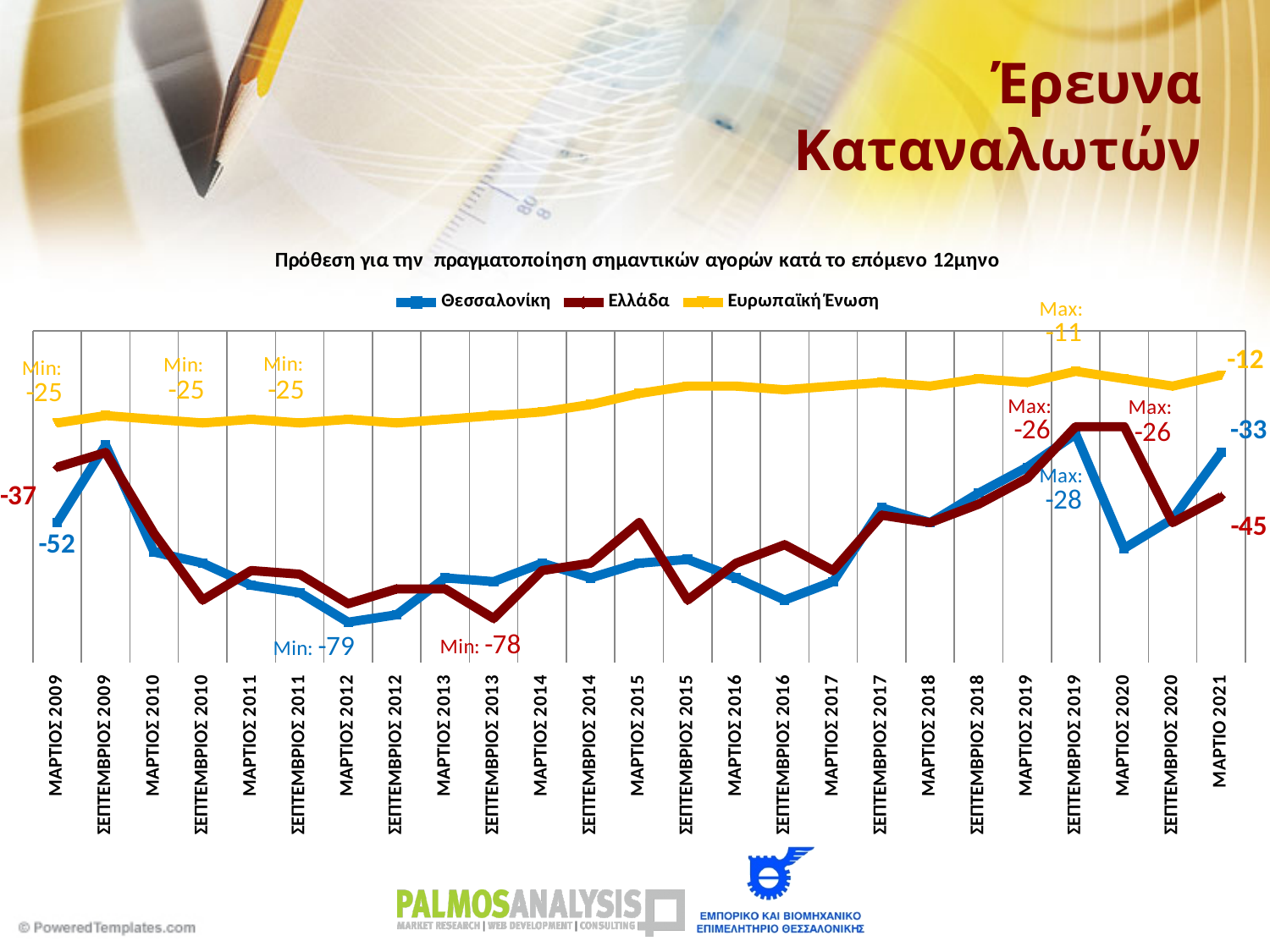
How many series does the legend list? 3 What kind of chart is shown on the slide? line chart What is the value for Ευρωπαϊκή Ένωση in ΜΑΡΤΙΟ 2021? -12 What is the value for Ελλάδα in ΜΑΡΤΙΟΣ 2009? -37 Which series has the higher value in ΜΑΡΤΙΟ 2021, Θεσσαλονίκη or Ελλάδα? Θεσσαλονίκη Which series is drawn in yellow? Ευρωπαϊκή Ένωση What is the maximum value of the Ευρωπαϊκή Ένωση series, and in which period does it occur? -11, ΣΕΠΤΕΜΒΡΙΟΣ 2019 What is the minimum value of the Ελλάδα series? -78 What is the value for Ελλάδα in ΜΑΡΤΙΟ 2021? -45 What is the difference between the Θεσσαλονίκη value (-33) and the Ελλάδα value (-45) in ΜΑΡΤΙΟ 2021? 12 What is the minimum value of the Θεσσαλονίκη series, and in which period does it occur? -79, ΜΑΡΤΙΟΣ 2012 What is the value for Θεσσαλονίκη in ΜΑΡΤΙΟΣ 2009? -52